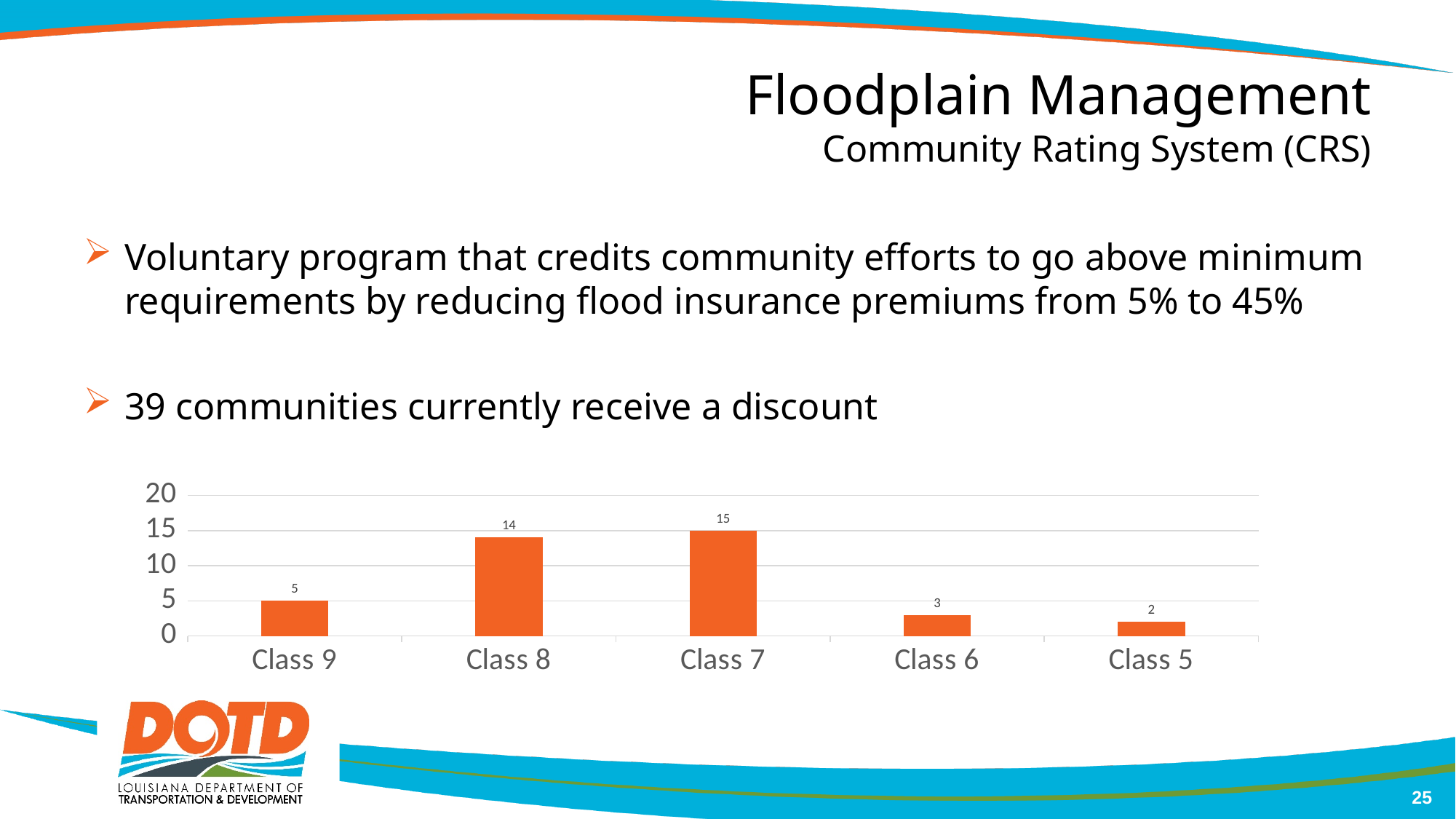
What colour are the bars in the chart? Orange Which class has the highest value? Class 7 What kind of chart is shown on the slide? Bar chart What is the difference between the values for Class 7 and Class 9? 10 What is the value for Class 7? 15 What is the value for Class 8? 14 Which class has the lowest value? Class 5 Which is larger, the value for Class 8 or the value for Class 6? Class 8 What is the value for Class 5? 2 How many classes are shown on the x axis of the chart? 5 What is the value for Class 9? 5 What is the value for Class 6? 3